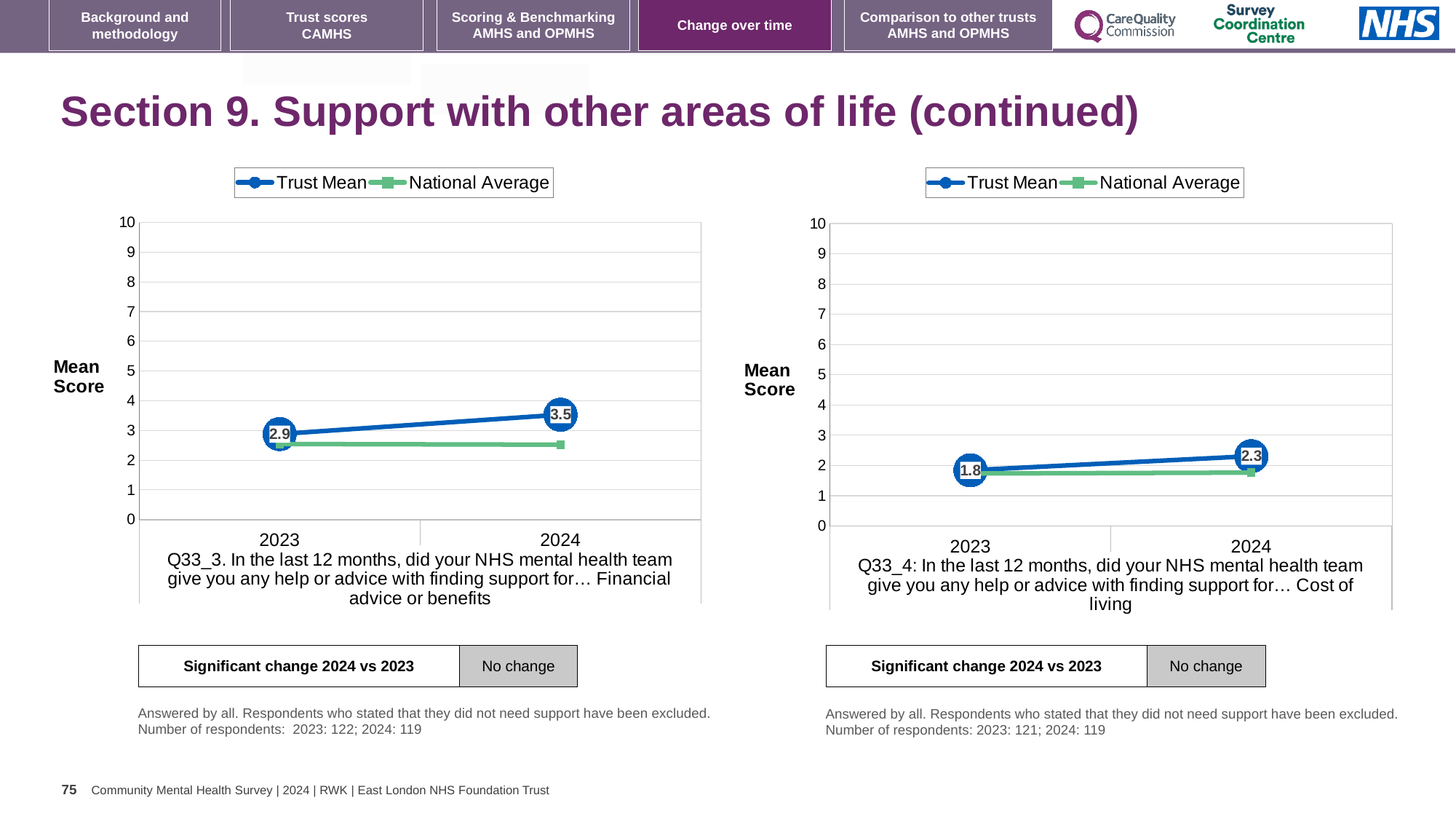
In the right chart (Q33_4), is the Trust Mean for 2024 greater or less than 3? less In the left chart (Q33_3), by how much did the Trust Mean change from 2023 to 2024? 0.6 What kind of chart is the left chart (Q33_3)? line chart In the left chart (Q33_3, Financial advice or benefits), what is the Trust Mean for 2024? 3.5 How many series does the legend of the right chart (Q33_4) list? 2 How many years are shown on the x axis of the left chart (Q33_3)? 2 In the right chart (Q33_4, Cost of living), what is the Trust Mean for 2024? 2.3 In the left chart (Q33_3, Financial advice or benefits), what is the Trust Mean for 2023? 2.9 In the left chart (Q33_3), does the Trust Mean rise or fall from 2023 to 2024? rise In the right chart (Q33_4, Cost of living), what is the Trust Mean for 2023? 1.8 In the right chart (Q33_4), by how much did the Trust Mean change from 2023 to 2024? 0.5 In the left chart (Q33_3), is the National Average for 2024 greater or less than the Trust Mean for 2024? less